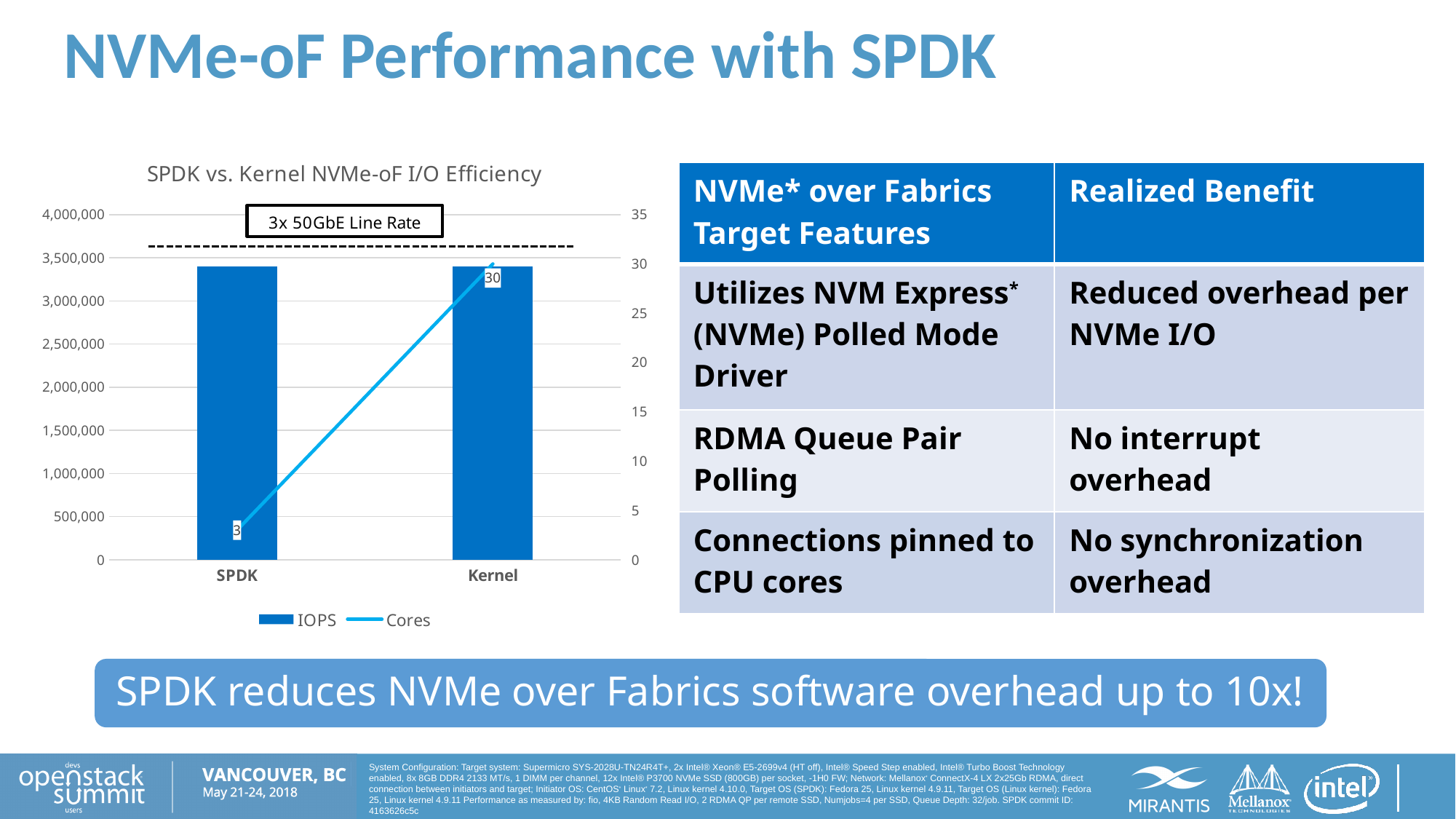
Is the IOPS value for SPDK greater or less than 3,000,000? greater What is the difference in Cores between Kernel and SPDK in the chart? 27 What is the Cores value for SPDK in the SPDK vs. Kernel NVMe-oF I/O Efficiency chart? 3 Which uses more cores in the chart, SPDK or Kernel? Kernel How many series does the chart's legend list? 2 Which category has the lowest Cores value in the chart? SPDK How many categories are shown on the x axis of the chart? 2 What label is shown on the dashed horizontal line in the chart? 3x 50GbE Line Rate Is the IOPS value for Kernel greater or less than 3,500,000? less What is the Cores value for Kernel in the SPDK vs. Kernel NVMe-oF I/O Efficiency chart? 30 Does the Cores line rise or fall from SPDK to Kernel? rise Which category has the highest Cores value in the chart? Kernel